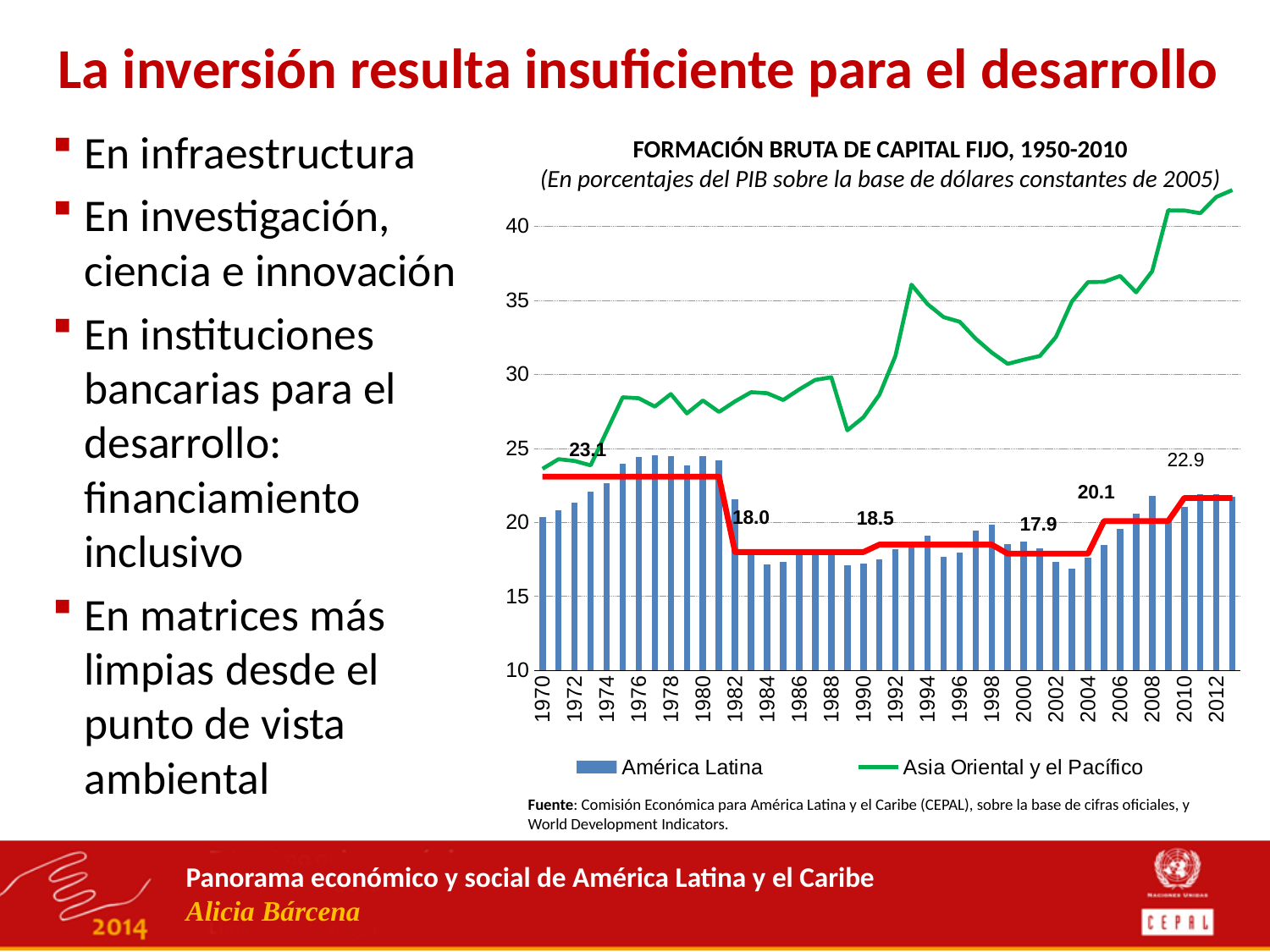
Which labelled value on the red line is the highest? 23.1 In 2012, which series has the larger value, América Latina or Asia Oriental y el Pacífico? Asia Oriental y el Pacífico What is the difference between the labelled values 23.1 and 17.9 on the red line? 5.2 Which labelled value on the red line is the lowest? 17.9 How many series does the chart legend list? 2 Is the value for Asia Oriental y el Pacífico in 1970 greater or less than 25? less What is the last labelled value on the red line, at the right end of the chart? 22.9 What is the first labelled value on the red line, at the start of the 1970s? 23.1 What kind of chart is used to show the América Latina series? Bar chart What is the labelled value on the red line for the period around 1982-1989? 18.0 Is the value for Asia Oriental y el Pacífico in 2012 greater or less than 40? greater What is the title of the chart? FORMACIÓN BRUTA DE CAPITAL FIJO, 1950-2010